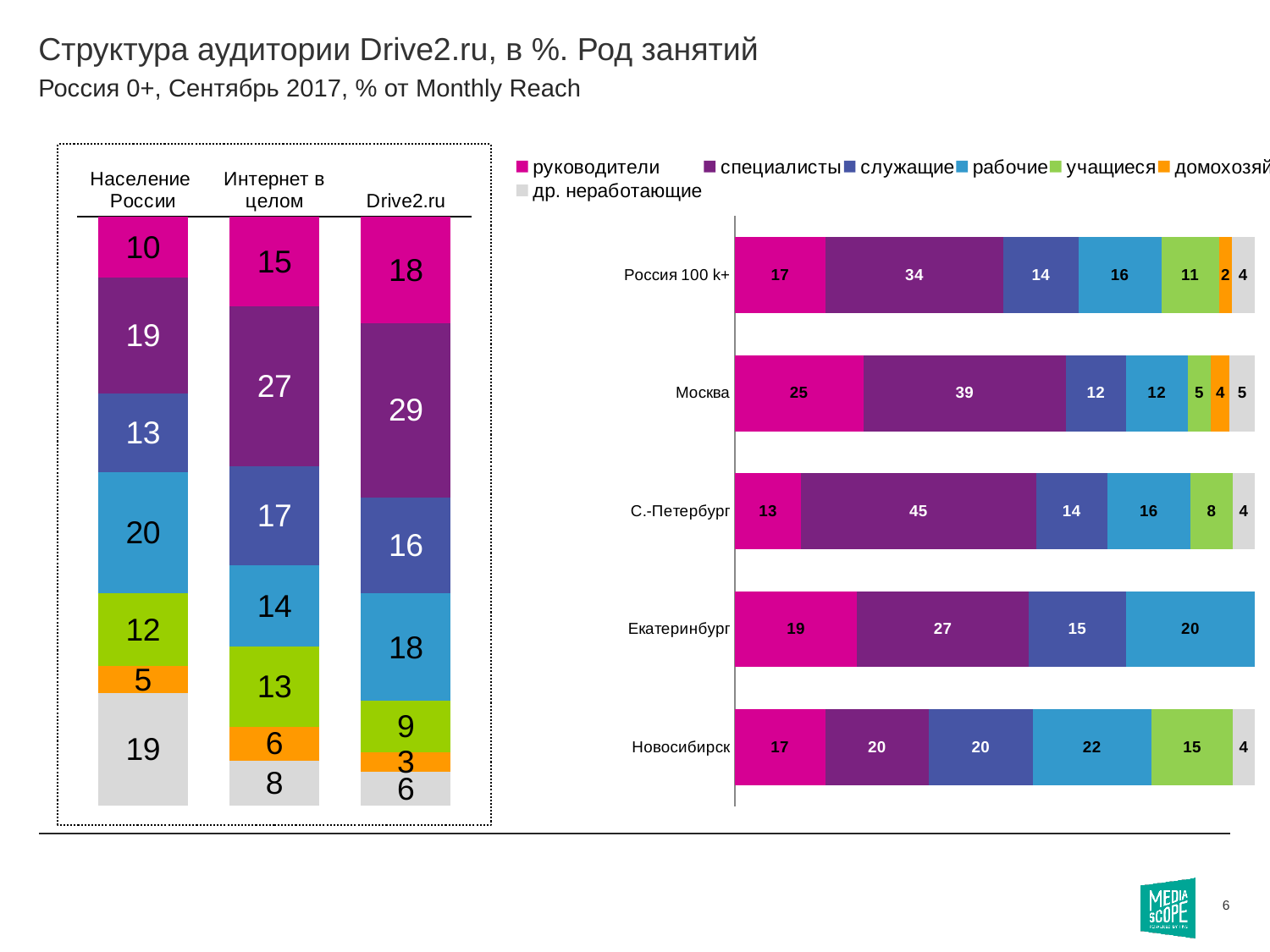
In the left chart, what is the value of the pink (руководители) segment for Drive2.ru? 18 What type of chart is the right chart? Stacked bar chart In the left chart, what is the difference between the grey (др. неработающие) segment for Население России and for Drive2.ru? 13 In the right chart, which is larger: рабочие for Новосибирск or рабочие for Москва? Новосибирск In the right chart, how many categories (rows) are shown? 5 In the right chart, what is the difference between специалисты for Москва and специалисты for Екатеринбург? 12 In the right chart, what is the value of руководители for Москва? 25 In the right chart, which city has the highest value for специалисты? С.-Петербург In the left chart, how many bars (categories) are shown? 3 In the left chart, which of the three bars has the largest purple (специалисты) segment? Drive2.ru In the right chart, what is the value of специалисты for С.-Петербург? 45 In the left chart, what is the value of the purple (специалисты) segment for Интернет в целом? 27